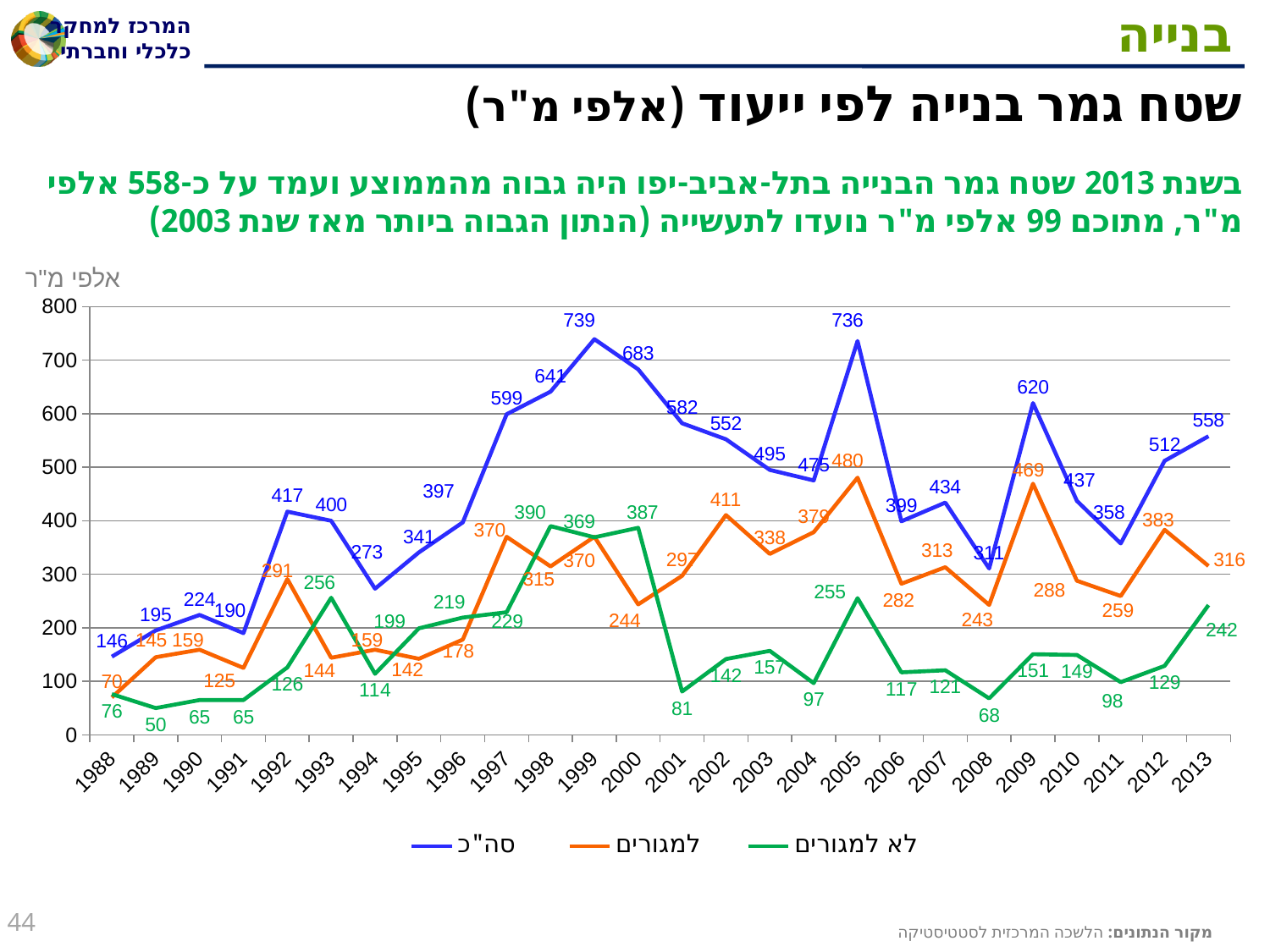
Is the value of the סה"כ series in 2009 greater or less than 600? greater What is the difference between the סה"כ value and the למגורים value in 2013? 242 How many years are plotted along the x axis? 26 What is the value of the לא למגורים series in 2000? 387 In which year is the לא למגורים series at its lowest value? 1989 What is the value of the למגורים series in 2005? 480 Does the סה"כ series rise or fall from 2010 to 2011? fall What kind of chart is shown on the slide? line chart In which year does the סה"כ series reach its highest value? 1999 What is the value of the סה"כ series in 2013? 558 How many series does the legend list? 3 In 1998, which is larger: the למגורים value or the לא למגורים value? לא למגורים